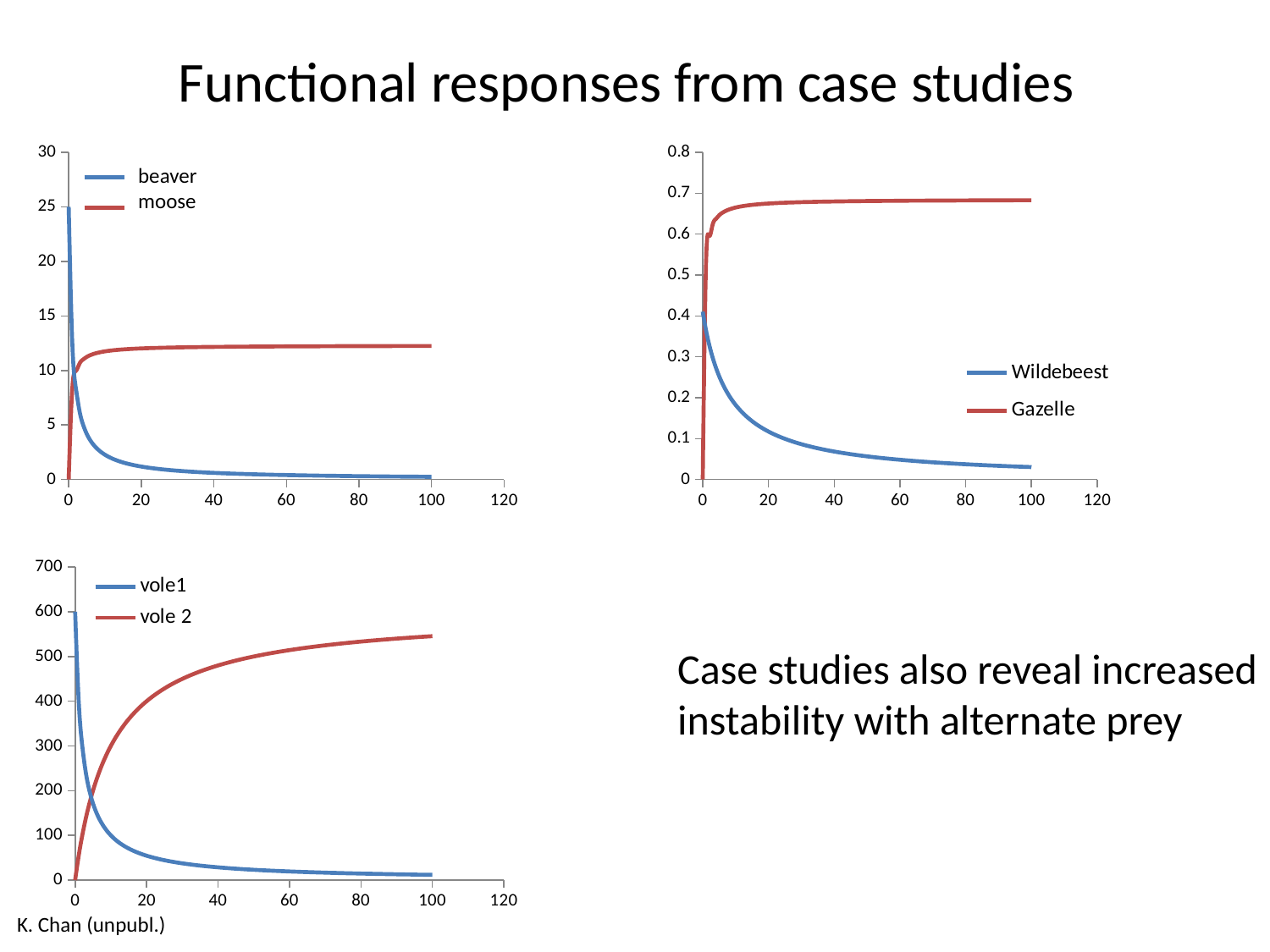
How many series does the legend of the top-right chart list? 2 In the bottom-left chart, which two series are listed in the legend? vole1 and vole 2 In the top-right chart, which series has the larger value at x = 100, Wildebeest or Gazelle? Gazelle In the top-left chart, does the beaver series rise or fall as the x axis increases? fall In the top-right chart, does the Wildebeest series rise or fall as the x axis increases? fall In the top-left chart, does the moose series rise or fall as the x axis increases? rise In the bottom-left chart, is the value for vole 2 at x = 100 greater or less than 500? greater In the top-right chart, is the value for Gazelle at x = 100 greater or less than 0.6? greater In the top-left chart, is the value for moose at x = 100 greater or less than 10? greater What kind of chart is the top-left chart with the beaver and moose series? line chart